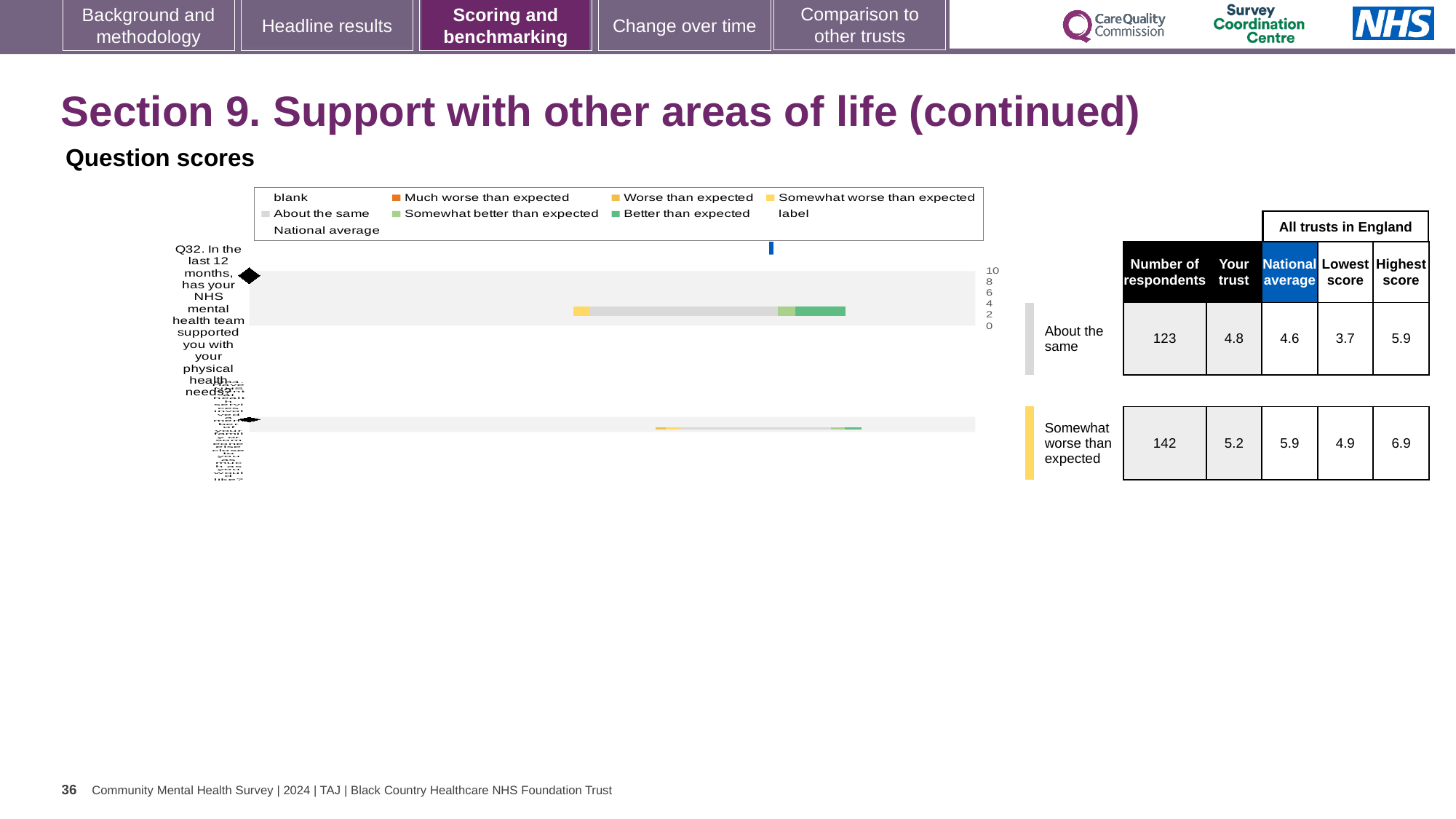
What is the 'Your trust' score for the question rated 'Somewhat worse than expected'? 5.2 What is the lowest score among all trusts in England for the question rated 'Somewhat worse than expected'? 4.9 What is the difference between the highest and lowest scores across all trusts in England for Q32? 2.2 What is the difference between the national average and the trust's score for the question rated 'Somewhat worse than expected'? 0.7 How many respondents answered Q32 (support with physical health needs)? 123 What is the 'Your trust' score for Q32 (support with physical health needs)? 4.8 For Q32, is the trust's score higher or lower than the national average? higher What is the national average for Q32 (support with physical health needs)? 4.6 What kind of chart is used to show the question scores on this slide? bar chart What benchmark category is Q32 (support with physical health needs) assigned to? About the same What is the highest score among all trusts in England for Q32? 5.9 How many questions (rows) are plotted in the question scores chart? 2